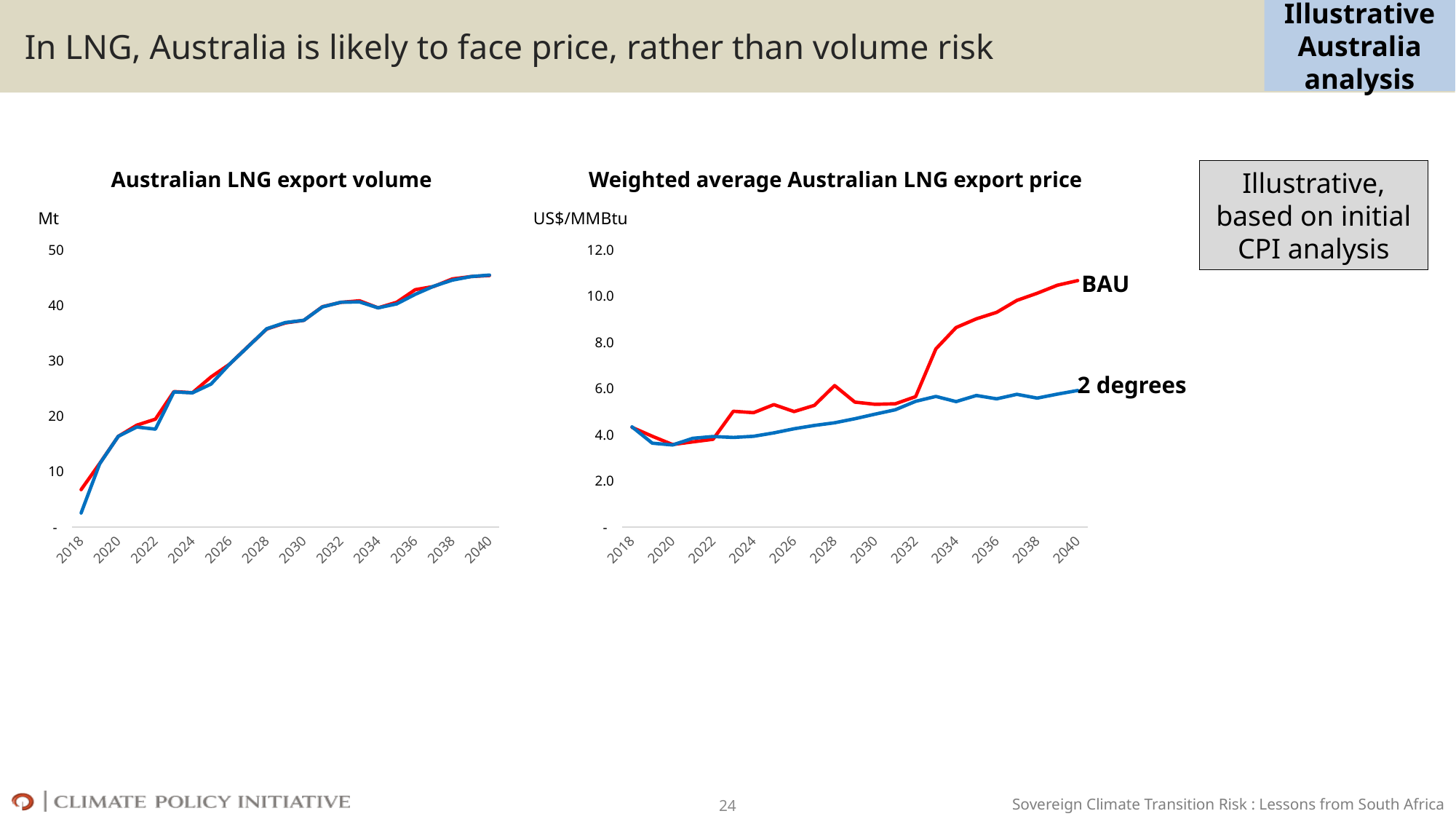
In the 'Weighted average Australian LNG export price' chart, is the 2 degrees value in 2040 greater or less than 4.0? greater In the 'Weighted average Australian LNG export price' chart, does the BAU series generally rise or fall from 2032 to 2040? rise In the 'Australian LNG export volume' chart, is the value in 2040 greater or less than 40? greater In the 'Weighted average Australian LNG export price' chart, is the BAU value in 2034 greater or less than 8.0? greater In the 'Weighted average Australian LNG export price' chart, which series is higher in 2040, BAU or 2 degrees? BAU What kind of chart is the 'Australian LNG export volume' chart? line chart What unit is shown on the y axis of the 'Australian LNG export volume' chart? Mt What kind of chart is the 'Weighted average Australian LNG export price' chart? line chart In the 'Weighted average Australian LNG export price' chart, what are the two series labelled? BAU and 2 degrees In the 'Australian LNG export volume' chart, do the values generally rise or fall from 2018 to 2040? rise